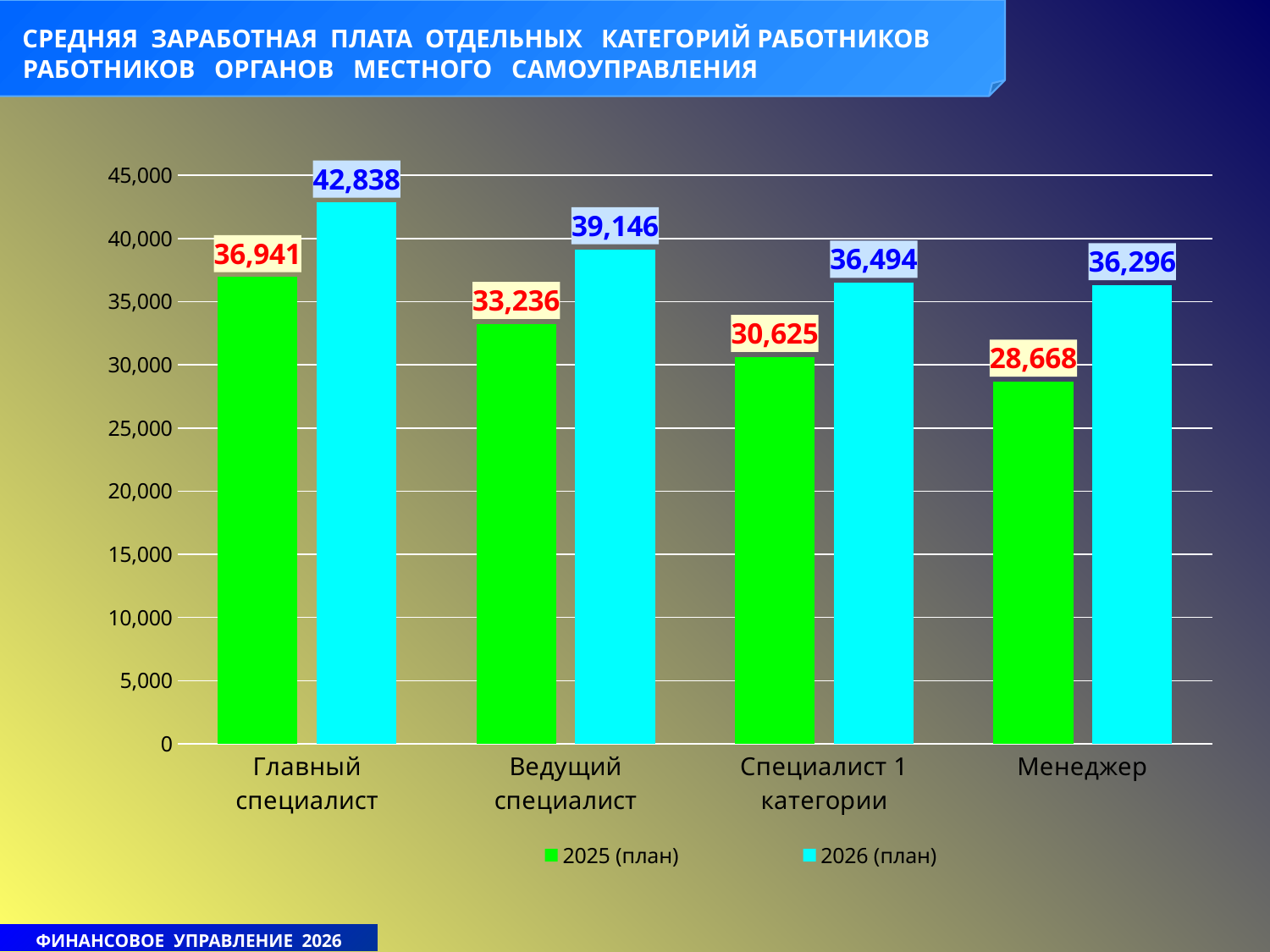
What is the 2026 (план) value for Ведущий специалист? 39,146 What is the 2025 (план) value for Главный специалист? 36,941 What is the 2025 (план) value for Специалист 1 категории? 30,625 Which category has the lowest 2025 (план) value? Менеджер Do the 2025 (план) values rise or fall from left to right across the categories? Fall How many categories are shown on the x axis? 4 How many series does the legend list? 2 Which category has the highest 2026 (план) value? Главный специалист What is the difference between the 2026 (план) and 2025 (план) values for Главный специалист? 5,897 What kind of chart is shown on the slide? Bar chart What is the 2026 (план) value for Менеджер? 36,296 Which is larger: the 2025 (план) value for Ведущий специалист or the 2026 (план) value for Менеджер? 2026 (план) value for Менеджер